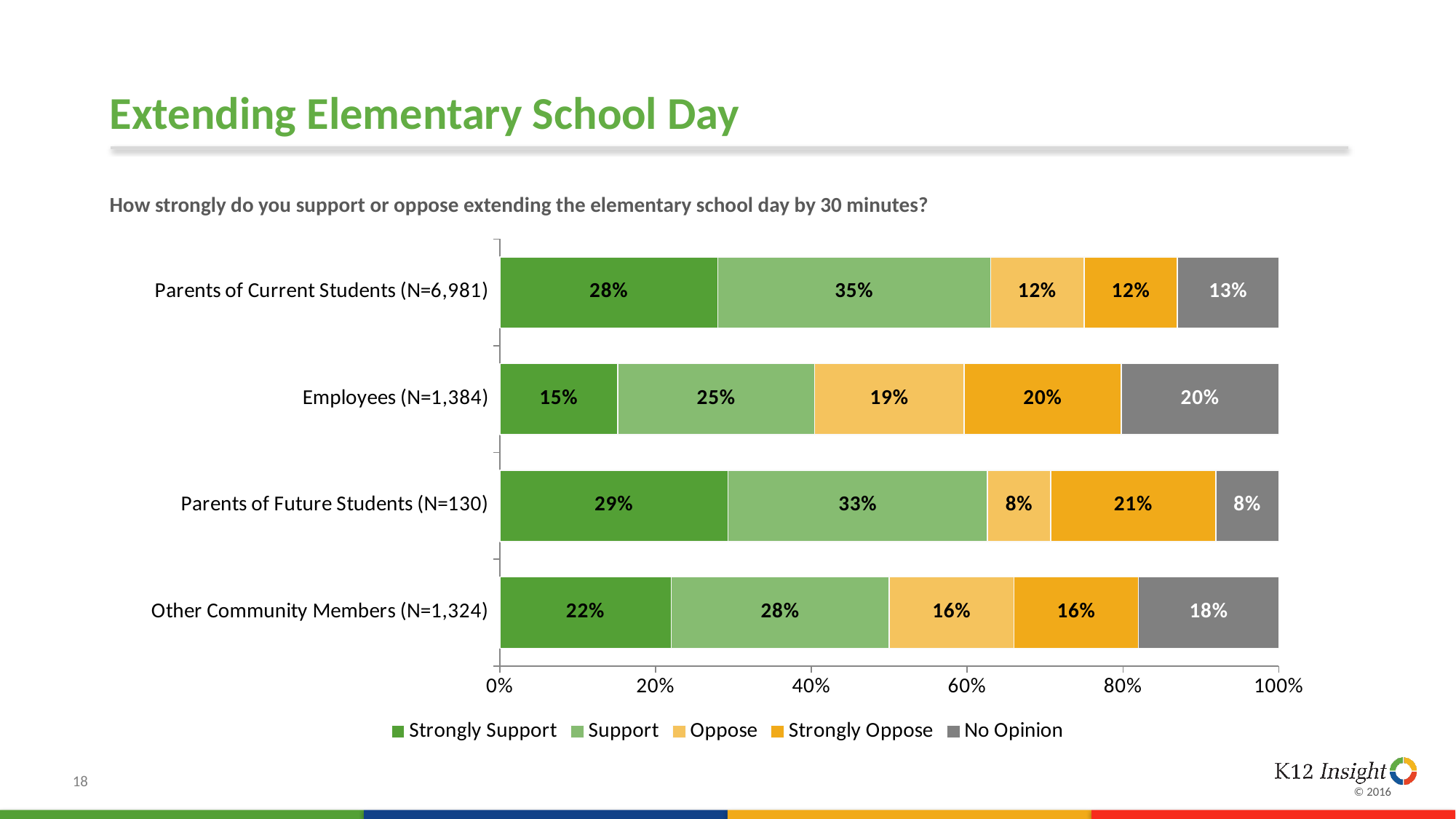
How many series does the legend list? 5 What is the combined Strongly Support and Support percentage for Parents of Future Students (N=130)? 62% What type of chart is shown on the slide? Stacked bar chart What is the difference between the Support percentage for Parents of Current Students (N=6,981) and for Employees (N=1,384)? 10 percentage points Which is larger: the Oppose percentage for Employees (N=1,384) or for Other Community Members (N=1,324)? Employees (N=1,384) What percentage of Parents of Current Students (N=6,981) Strongly Support extending the elementary school day? 28% How many respondent groups are shown in the chart? 4 What percentage of Other Community Members (N=1,324) responded Support? 28% What percentage of Parents of Future Students (N=130) responded No Opinion? 8% What percentage of Employees (N=1,384) responded Strongly Oppose? 20% Which group has the lowest Strongly Support percentage? Employees (N=1,384) Which group has the highest Strongly Support percentage? Parents of Future Students (N=130)